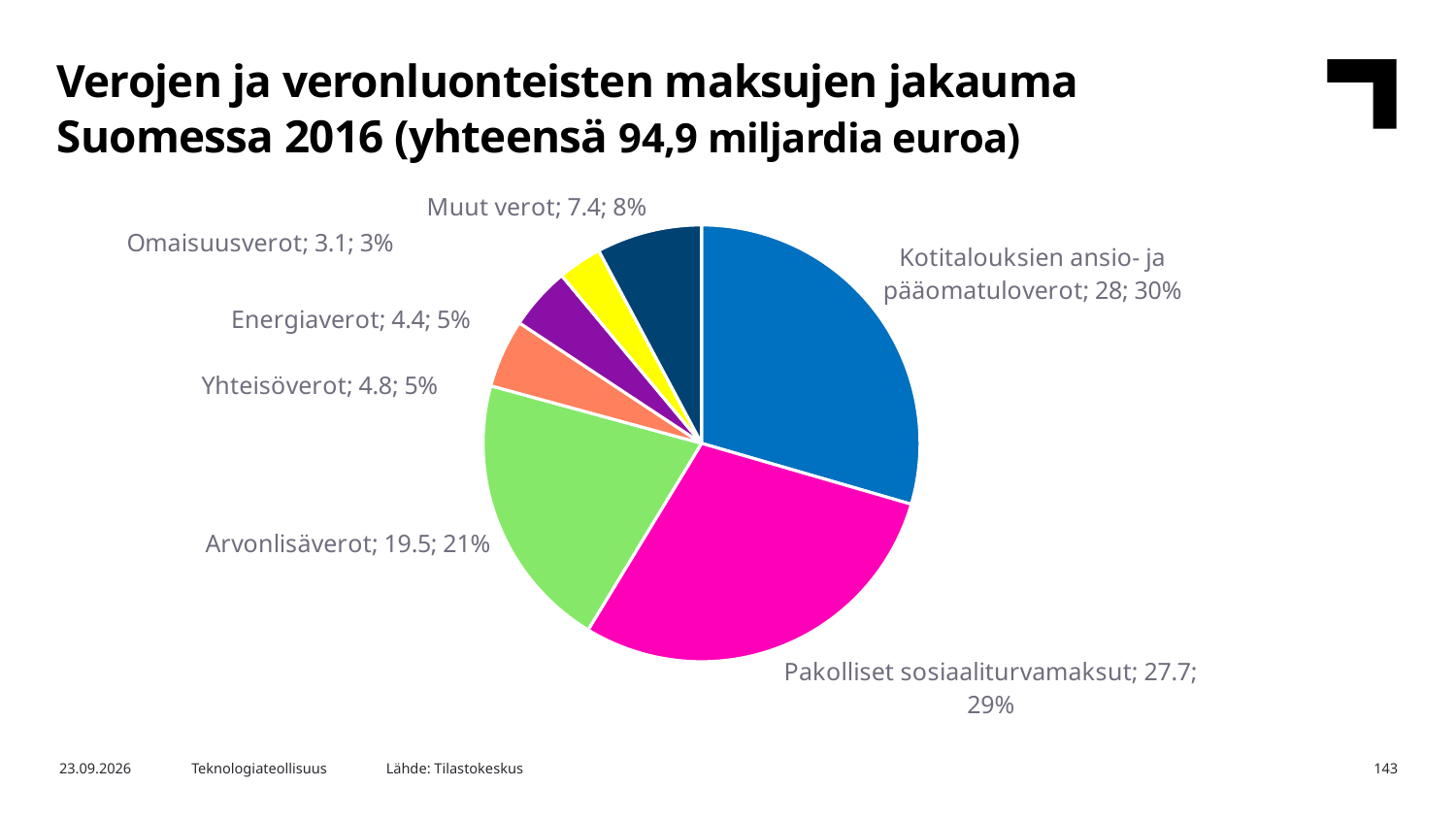
What is the value for Pakolliset sosiaaliturvamaksut? 27.7 What is the value for Muut verot? 7.4 Which category has the largest value? Kotitalouksien ansio- ja pääomatuloverot How many slices does the pie chart have? 7 Which category has the smallest value? Omaisuusverot What share of the pie does Kotitalouksien ansio- ja pääomatuloverot represent? 30% What total amount is stated in the chart title? 94,9 miljardia euroa What is the value for Arvonlisäverot? 19.5 What share of the pie does Arvonlisäverot represent? 21% What kind of chart is shown on the slide? pie chart Which is larger, the value for Yhteisöverot or the value for Energiaverot? Yhteisöverot What is the difference between the values for Kotitalouksien ansio- ja pääomatuloverot and Pakolliset sosiaaliturvamaksut? 0.3